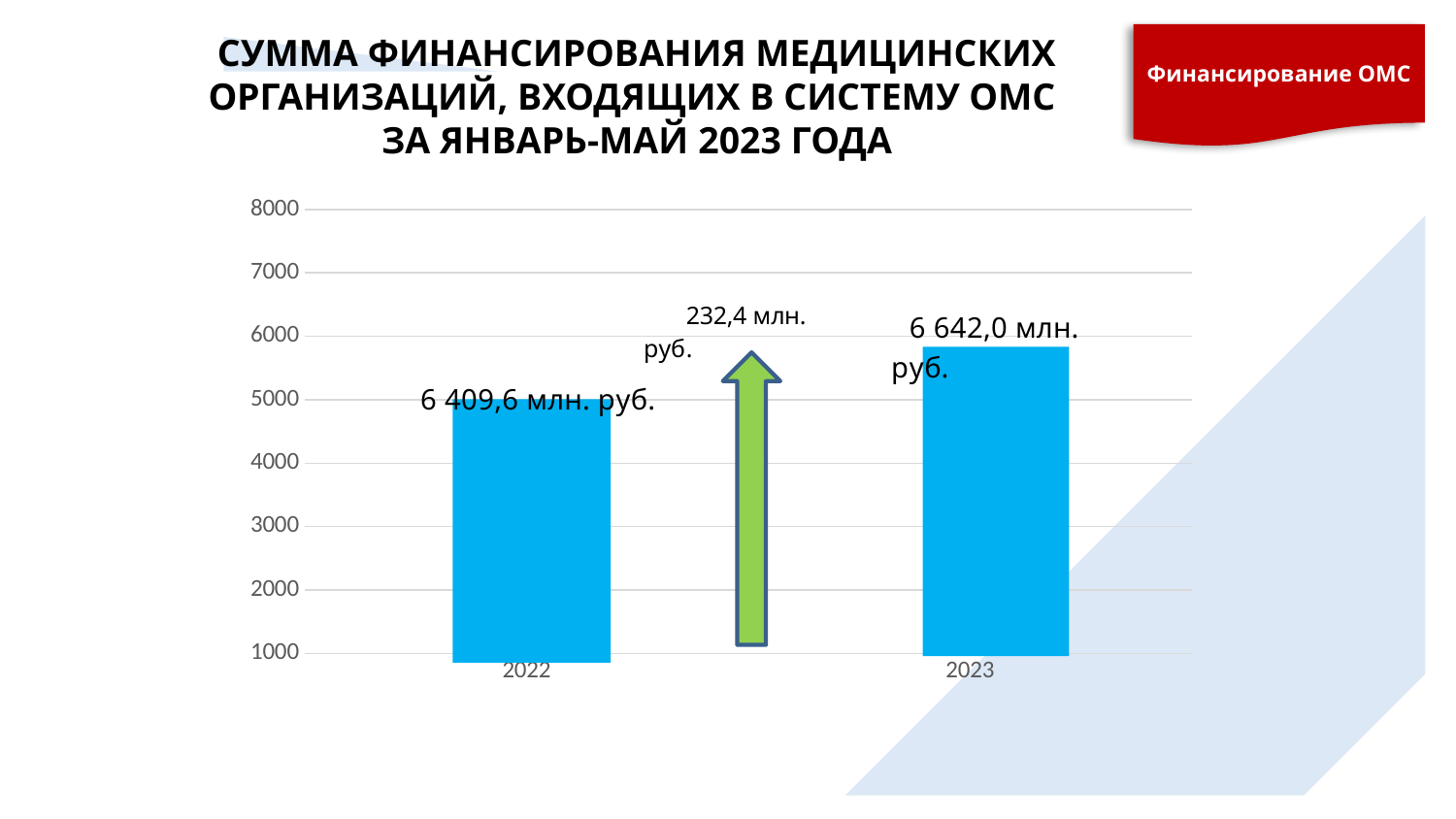
What is the difference between the values for 2023 and 2022? 232,4 млн. руб. Which is larger, the value for 2022 or the value for 2023? 2023 Which year has the highest value? 2023 Do the values rise or fall from 2022 to 2023? Rise What is the value for 2023? 6 642,0 млн. руб. Which year has the lowest value? 2022 What kind of chart is shown on the slide? Bar chart What is the highest value shown on the vertical axis? 8000 What is the value for 2022? 6 409,6 млн. руб. How many bars are shown in the chart? 2 What colour are the bars in the chart? Blue